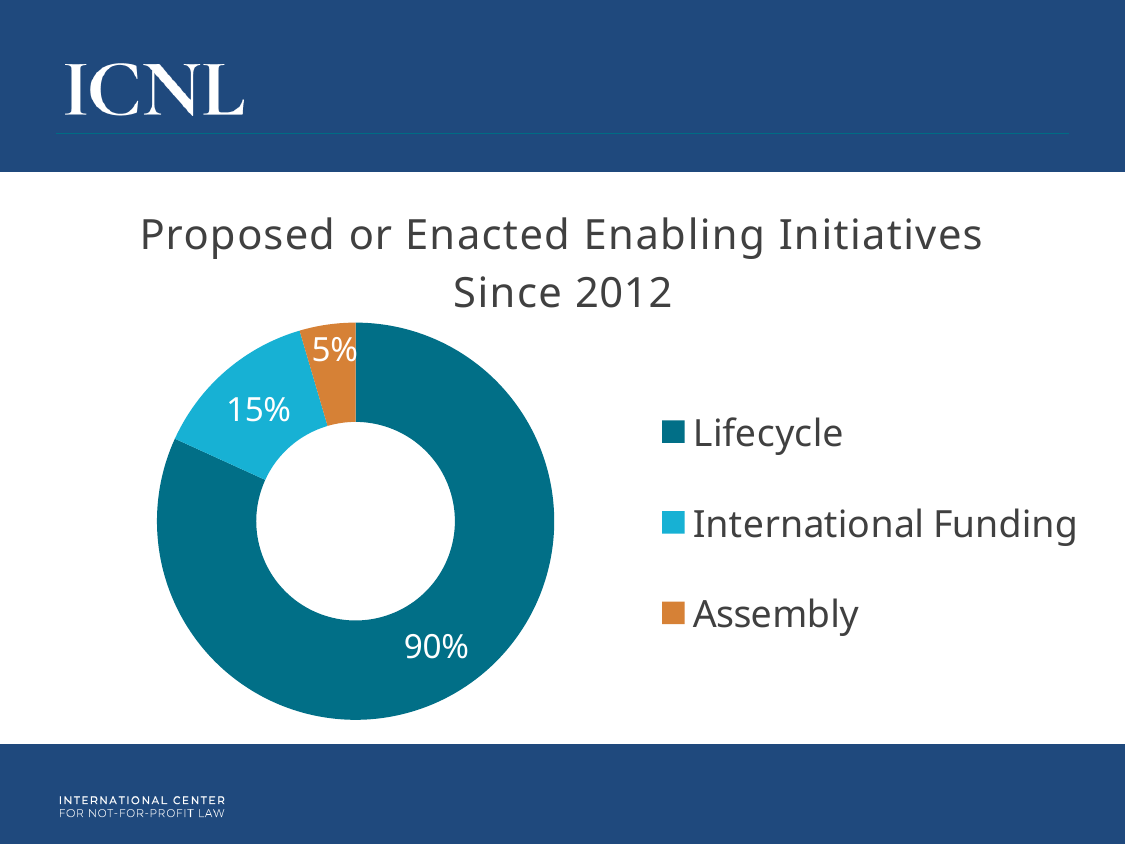
What is the difference in percentage points between the Lifecycle and International Funding slices? 75 Which is larger, the slice for International Funding or the slice for Assembly? International Funding What percentage is shown for Assembly? 5% What is the title of the chart? Proposed or Enacted Enabling Initiatives Since 2012 What percentage is shown for Lifecycle? 90% Which category has the smallest slice? Assembly What kind of chart is shown on the slide? Doughnut (pie) chart What percentage is shown for International Funding? 15% Which category is shown in orange? Assembly Which category has the largest slice? Lifecycle How many categories does the chart show? 3 What is the difference in percentage points between the International Funding and Assembly slices? 10